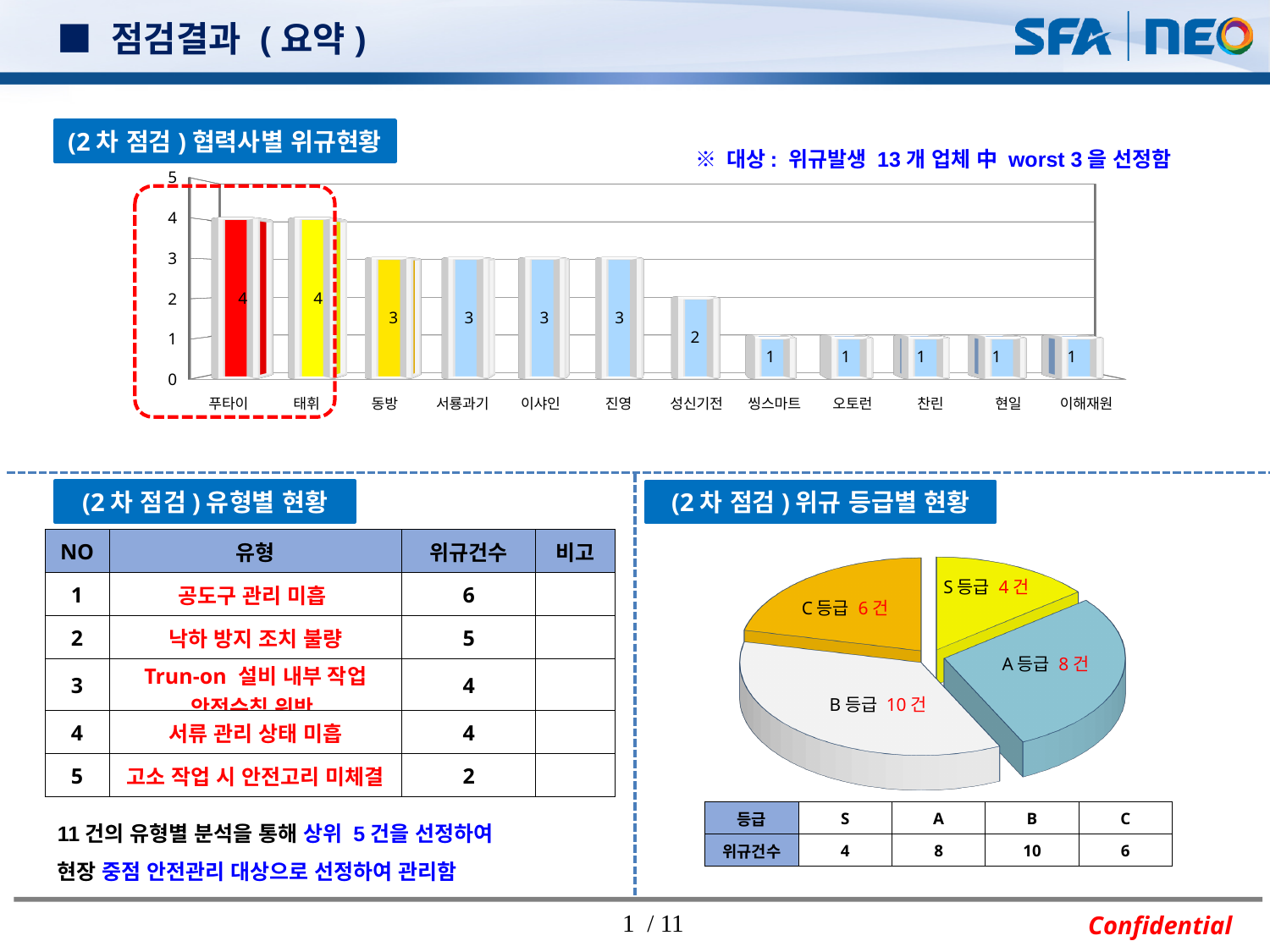
In the pie chart '(2차 점검) 위규 등급별 현황', which 등급 has the smallest slice? S 등급 In the bar chart '(2차 점검) 협력사별 위규현황', how many categories are shown on the x axis? 12 In the pie chart '(2차 점검) 위규 등급별 현황', how many 건 are shown for B 등급? 10 건 In the bar chart '(2차 점검) 협력사별 위규현황', what is the value for 성신기전? 2 In the pie chart '(2차 점검) 위규 등급별 현황', which 등급 has the largest slice? B 등급 In the bar chart '(2차 점검) 협력사별 위규현황', what is the value for 동방? 3 In the bar chart '(2차 점검) 협력사별 위규현황', which is larger, the value for 진영 or the value for 오토런? 진영 In the bar chart '(2차 점검) 협력사별 위규현황', what is the difference between the values for 태휘 and 씽스마트? 3 In the bar chart '(2차 점검) 협력사별 위규현황', what is the value for 푸타이? 4 What kind of chart is '(2차 점검) 위규 등급별 현황'? pie chart In the bar chart '(2차 점검) 협력사별 위규현황', do the values generally rise or fall from left to right along the x axis? fall What kind of chart is '(2차 점검) 협력사별 위규현황'? bar chart